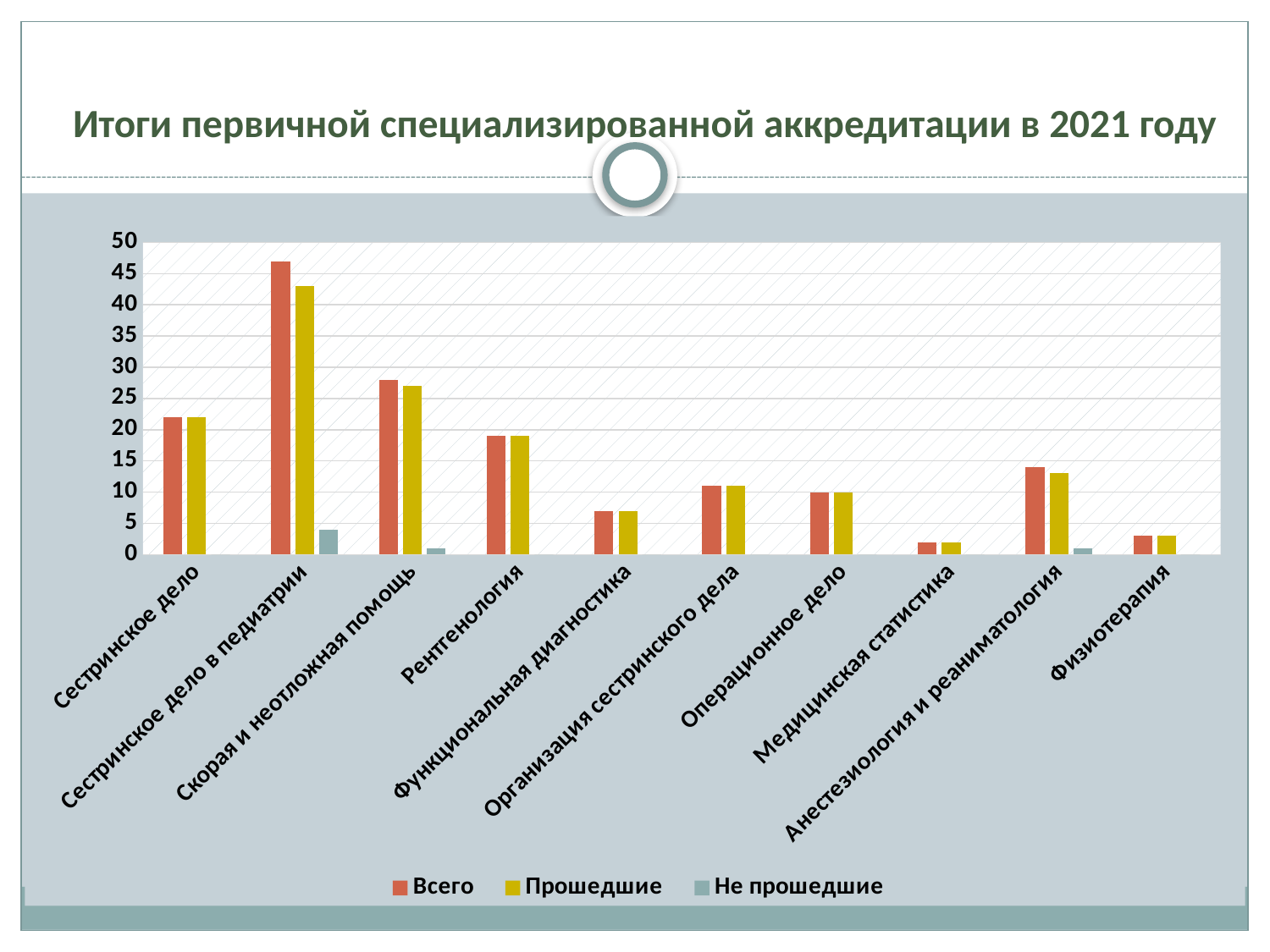
Is the value for Прошедшие in Скорая и неотложная помощь greater or less than 25? greater Which is larger: the Прошедшие value for Анестезиология и реаниматология or the Прошедшие value for Функциональная диагностика? Анестезиология и реаниматология Which category has the lowest value for Всего? Медицинская статистика How many series does the legend list? 3 Which is larger: the Всего value for Сестринское дело or the Всего value for Рентгенология? Сестринское дело Is the value for Всего in Физиотерапия greater or less than 5? less Is the value for Не прошедшие in Сестринское дело в педиатрии greater or less than 5? less How many categories are shown on the x axis? 10 Which category has the highest value for Всего? Сестринское дело в педиатрии What is the title of the slide? Итоги первичной специализированной аккредитации в 2021 году What kind of chart is shown on the slide? bar chart